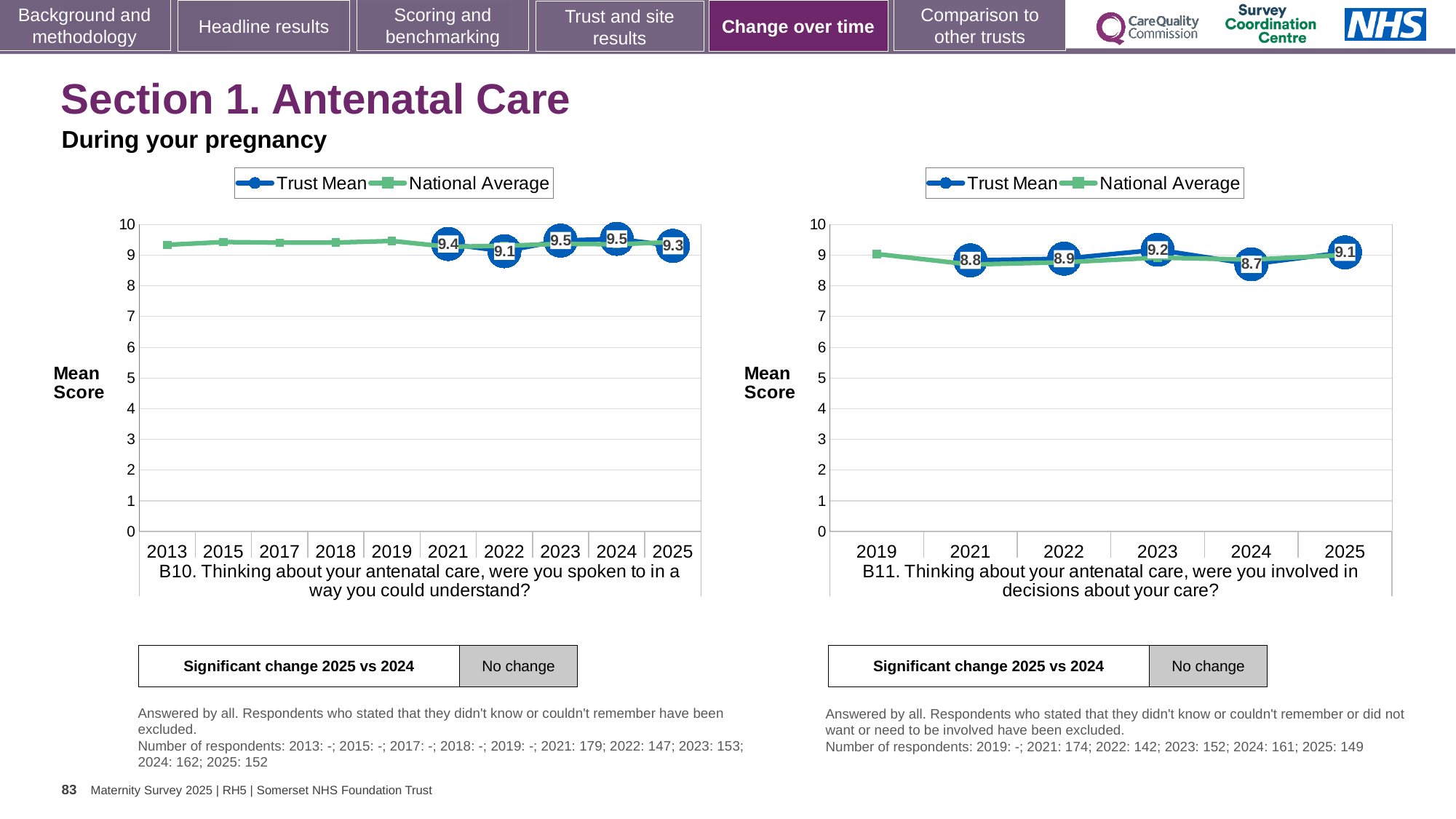
In the B11 chart on the right, which year has the highest Trust Mean? 2023 In the B11 chart on the right, is the National Average for 2019 greater or less than 8? greater In the B11 chart on the right, is the Trust Mean for 2025 larger than the Trust Mean for 2021? Yes In the B11 chart on the right, what is the Trust Mean for 2023? 9.2 In the B10 chart on the left, which year has the lowest labelled Trust Mean? 2022 In the B11 chart on the right, which year has the lowest Trust Mean? 2024 What type of chart is the B11 chart on the right? Line chart In the B10 chart on the left, what is the difference between the Trust Mean for 2024 and 2025? 0.2 In the B10 chart on the left, what is the Trust Mean for 2022? 9.1 In the B10 chart on the left, how many series does the legend list? 2 In the B10 chart on the left, how many years are shown on the x axis? 10 In the B10 chart on the left, what is the Trust Mean for 2025? 9.3